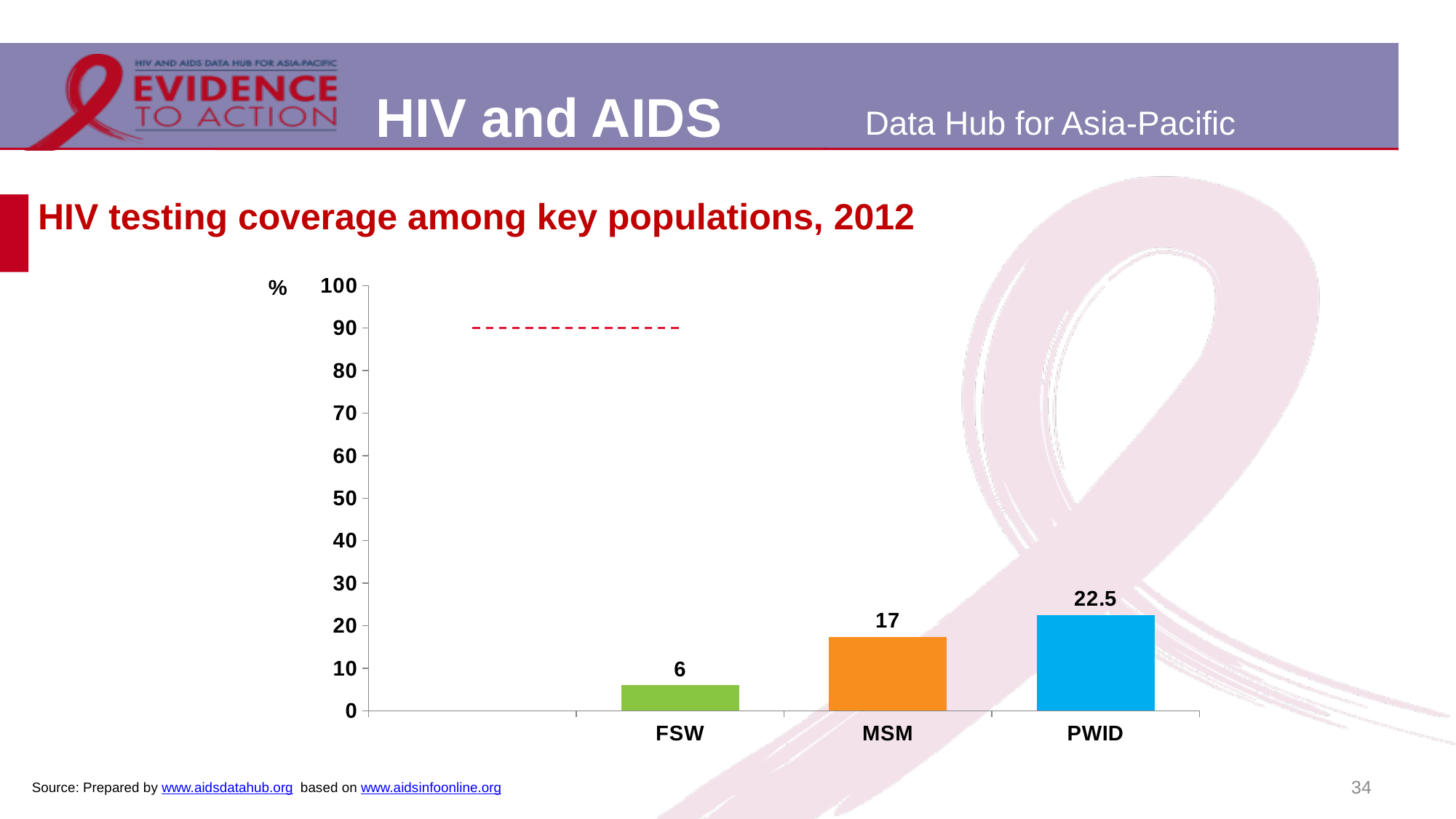
What is the title of the chart? HIV testing coverage among key populations, 2012 What is the HIV testing coverage value for MSM? 17 What is the HIV testing coverage value for PWID? 22.5 Which key population has the lowest HIV testing coverage? FSW What kind of chart is shown on the slide? Bar chart Which has a higher HIV testing coverage, FSW or MSM? MSM What is the HIV testing coverage value for FSW? 6 Which key population has the highest HIV testing coverage? PWID How many key populations are shown on the chart? 3 What is the difference between the HIV testing coverage for MSM and FSW? 11 What is the difference between the HIV testing coverage for PWID and MSM? 5.5 Is the value for PWID greater or less than 20? greater